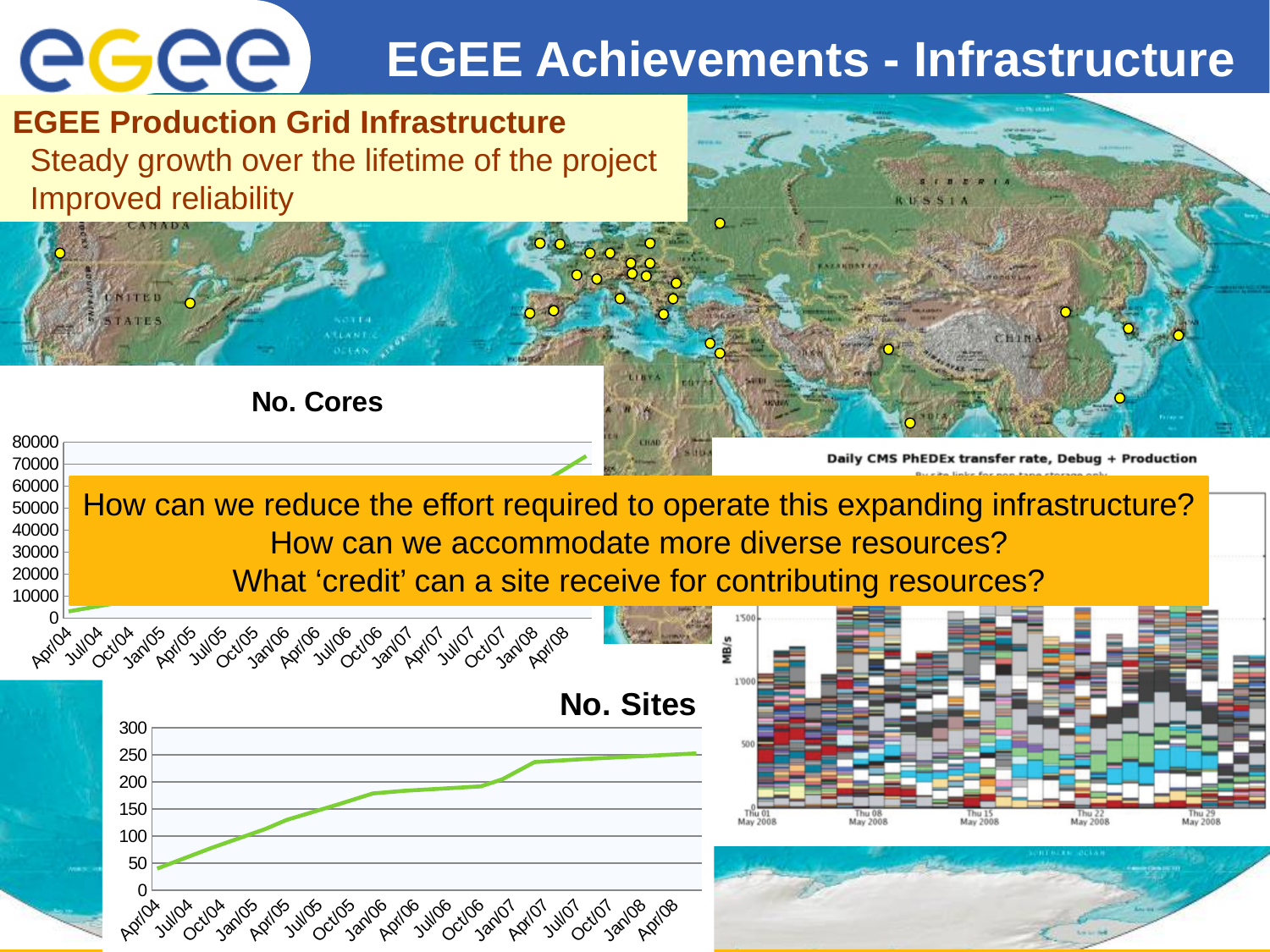
In the "No. Sites" chart, is the value for Apr/07 greater or less than 200? greater In the "No. Sites" chart, is the value for Oct/06 greater or less than 200? less In the "No. Cores" chart, is the value for Apr/04 greater or less than 10000? less In the "No. Sites" chart, do the values rise or fall from Apr/04 to Apr/08? rise How many time points are labelled on the x axis of the "No. Sites" chart? 17 What is the title of the line chart in the lower left of the slide? No. Sites What kind of chart is the "No. Cores" chart? line chart What kind of chart is the "Daily CMS PhEDEx transfer rate" chart on the right? stacked bar chart In the "No. Cores" chart, do the values rise or fall along the x axis? rise In the "No. Sites" chart, which is larger, the value for Jan/06 or the value for Jul/04? Jan/06